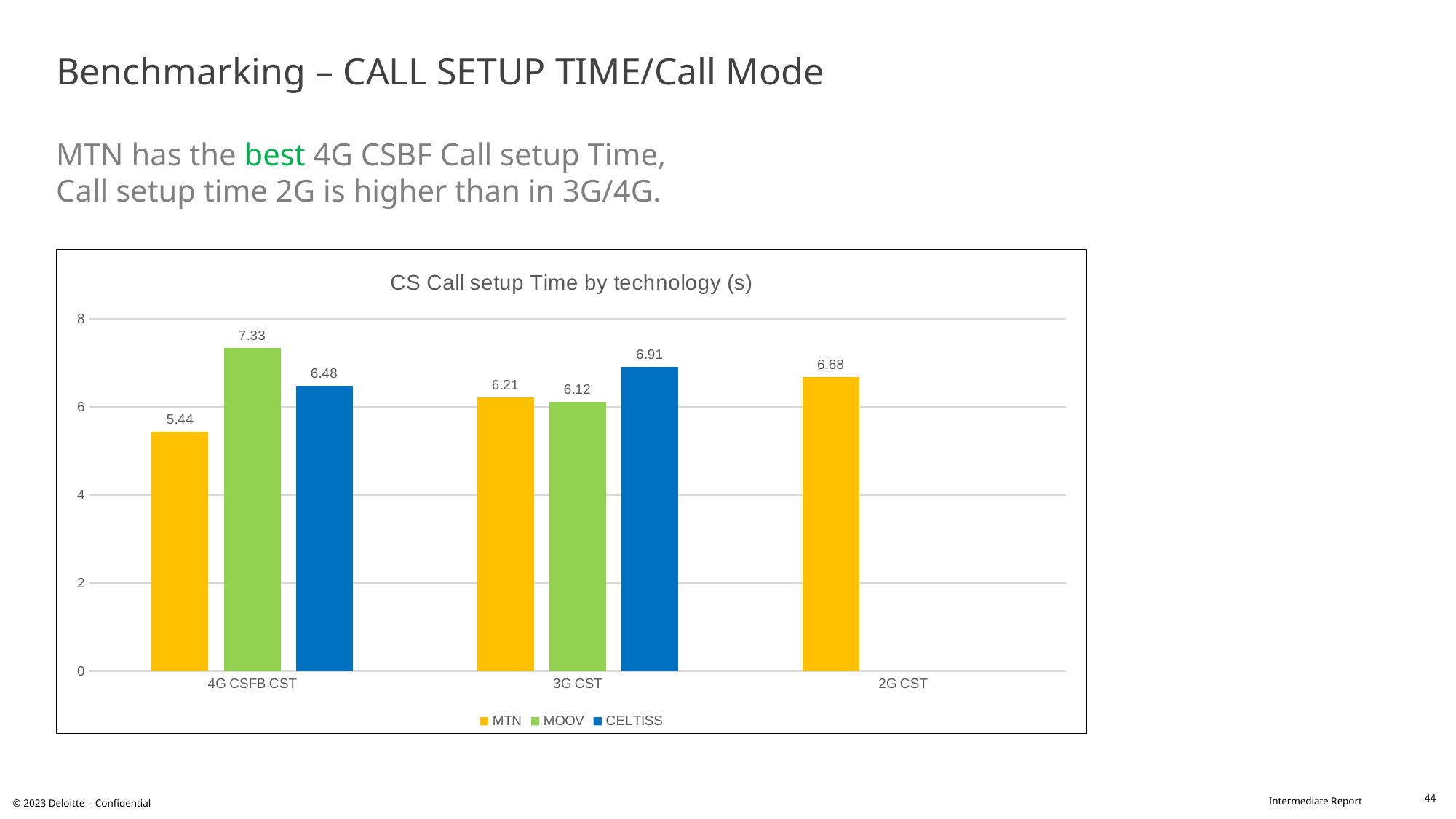
What is the CELTISS value for 3G CST? 6.91 Which operator has the lowest call setup time for 4G CSFB CST? MTN Which operator has the highest call setup time for 4G CSFB CST? MOOV Which is larger for 3G CST, the MTN value or the CELTISS value? CELTISS How many categories are shown on the x axis? 3 What kind of chart is shown on the slide? Bar chart What is the title of the chart? CS Call setup Time by technology (s) What is the MTN value for 4G CSFB CST? 5.44 What is the MOOV value for 3G CST? 6.12 What is the difference between the MOOV and MTN values for 4G CSFB CST? 1.89 How many series does the legend list? 3 What is the MTN value for 2G CST? 6.68